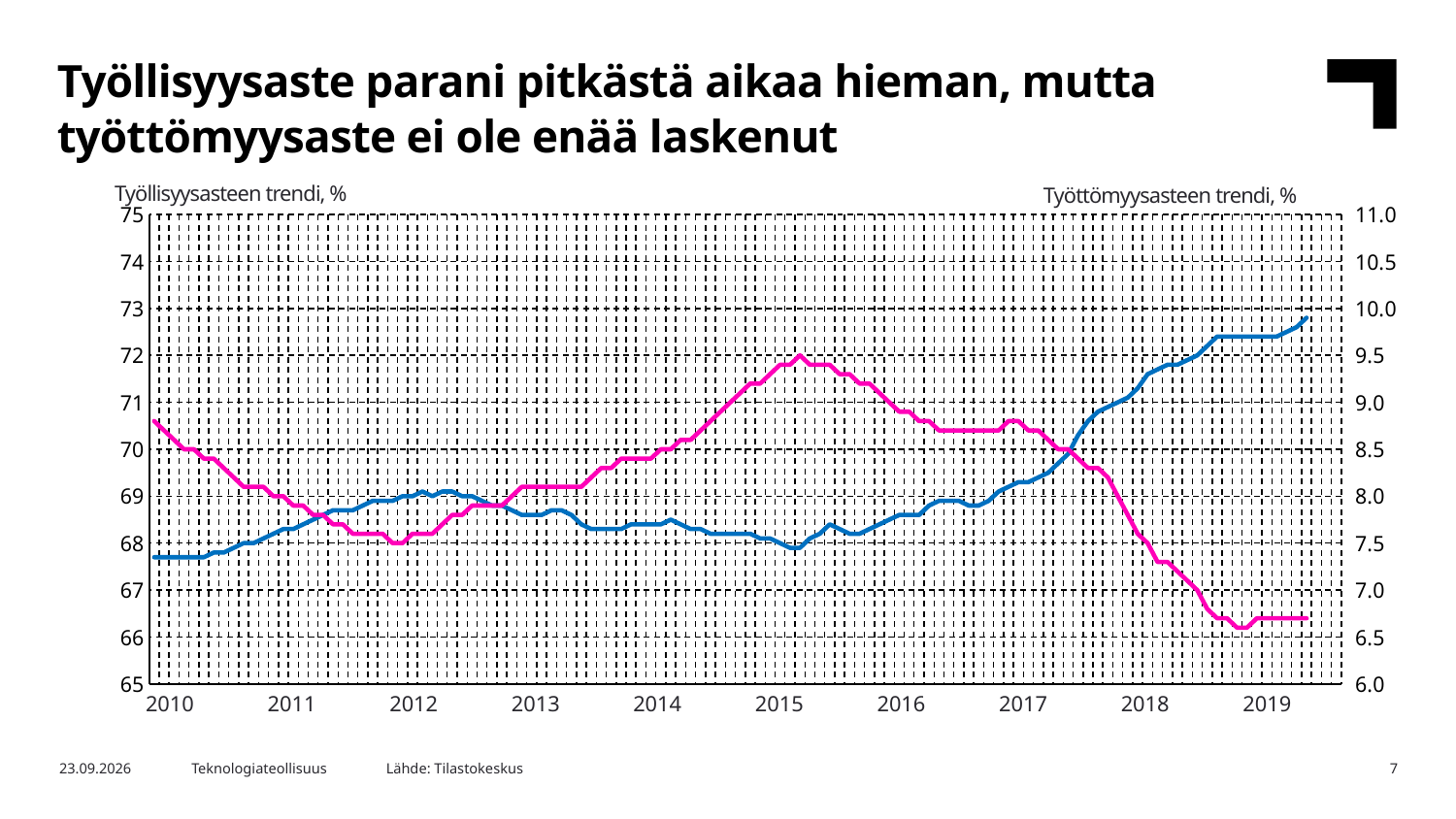
Is the value of the pink line (Työttömyysasteen trendi) at its 2015 peak greater or less than 9.0? greater How many year labels are shown on the x axis? 10 Is the value of the blue line (Työllisyysasteen trendi) at the start of 2015 greater or less than 69? less What is the title of the right vertical axis? Työttömyysasteen trendi, % Is the value of the pink line (Työttömyysasteen trendi) at the end of 2019 greater or less than 7.0? less What is the title of the left vertical axis? Työllisyysasteen trendi, % How many lines (series) are plotted on the chart? 2 What kind of chart is shown on the slide? line chart Does the blue line (Työllisyysasteen trendi) rise or fall from 2017 to 2019? rise Does the pink line (Työttömyysasteen trendi) rise or fall from 2015 to 2019? fall